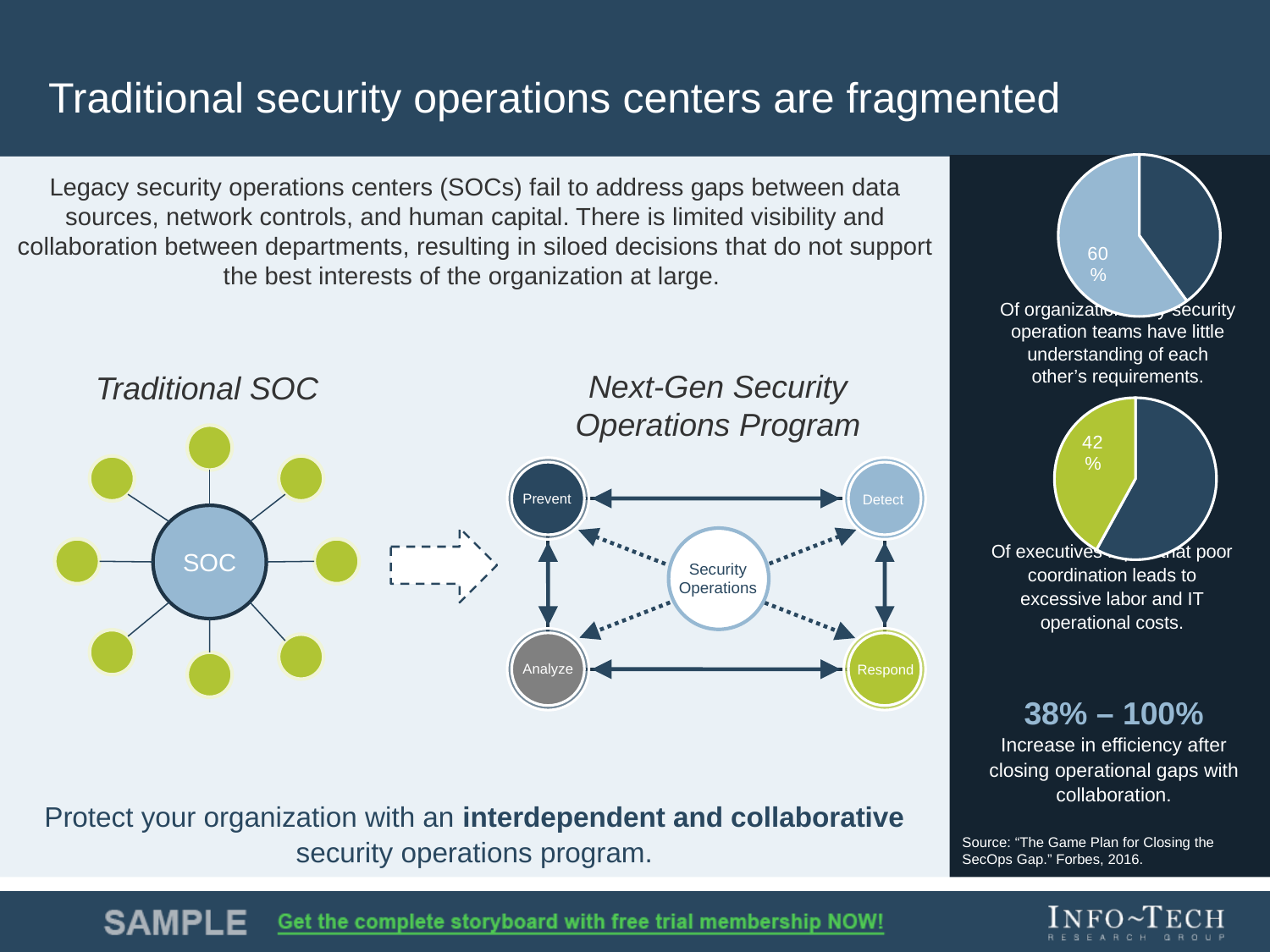
What kind of chart is the top chart on the right side of the slide? pie chart What share of the bottom pie chart on the right does the green slice represent? 42% Which labeled value is larger: the 60% slice in the top pie chart or the 42% slice in the bottom pie chart? the 60% slice in the top pie chart In the bottom pie chart on the right, what percentage is printed on the green slice? 42% In the top pie chart on the right, which slice is larger, the light blue slice or the dark blue slice? the light blue slice In the top pie chart on the right, what percentage is printed on the light blue slice? 60% How many slices does the top pie chart on the right have? 2 What is the difference between the labeled slice of the top pie chart (60%) and the labeled slice of the bottom pie chart (42%)? 18% In the bottom pie chart on the right, which slice is larger, the green slice or the dark blue slice? the dark blue slice What share of the top pie chart on the right does the light blue slice represent? 60% How many slices does the bottom pie chart on the right have? 2 What kind of chart is the bottom chart on the right side of the slide? pie chart